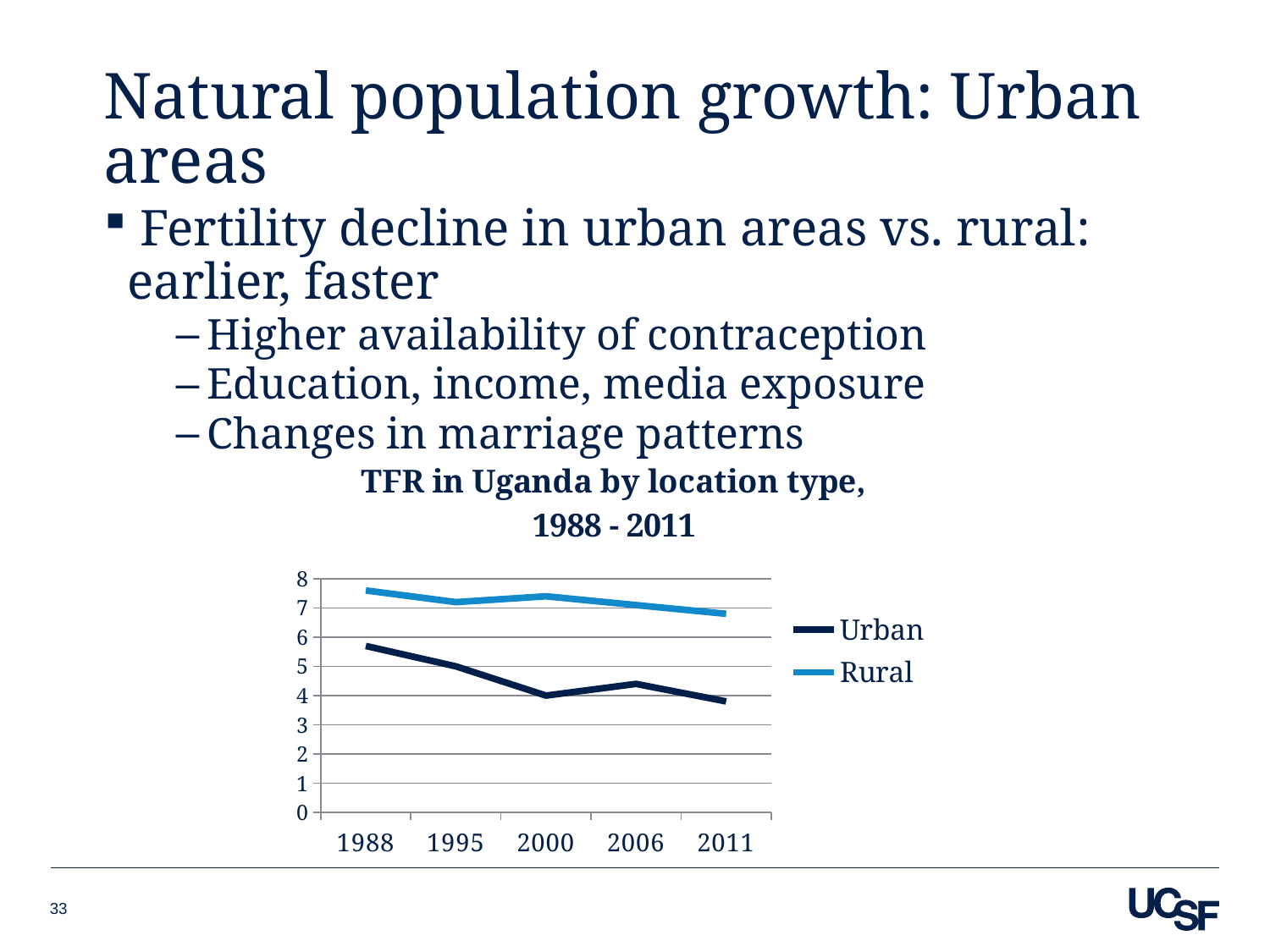
What kind of chart is shown on the slide? line chart Which series is drawn with the lighter blue line? Rural What is the title of the chart? TFR in Uganda by location type, 1988 - 2011 How many series does the chart legend list? 2 Is the Rural value for 2011 greater or less than 6? greater Is the Urban value for 1988 greater or less than 5? greater Does the Urban series generally rise or fall from 1988 to 2011? fall Is the Urban value for 2000 greater or less than 5? less How many years are plotted along the x axis of the chart? 5 In which year is the Urban series at its highest? 1988 Which series has the higher value in 1988, Urban or Rural? Rural